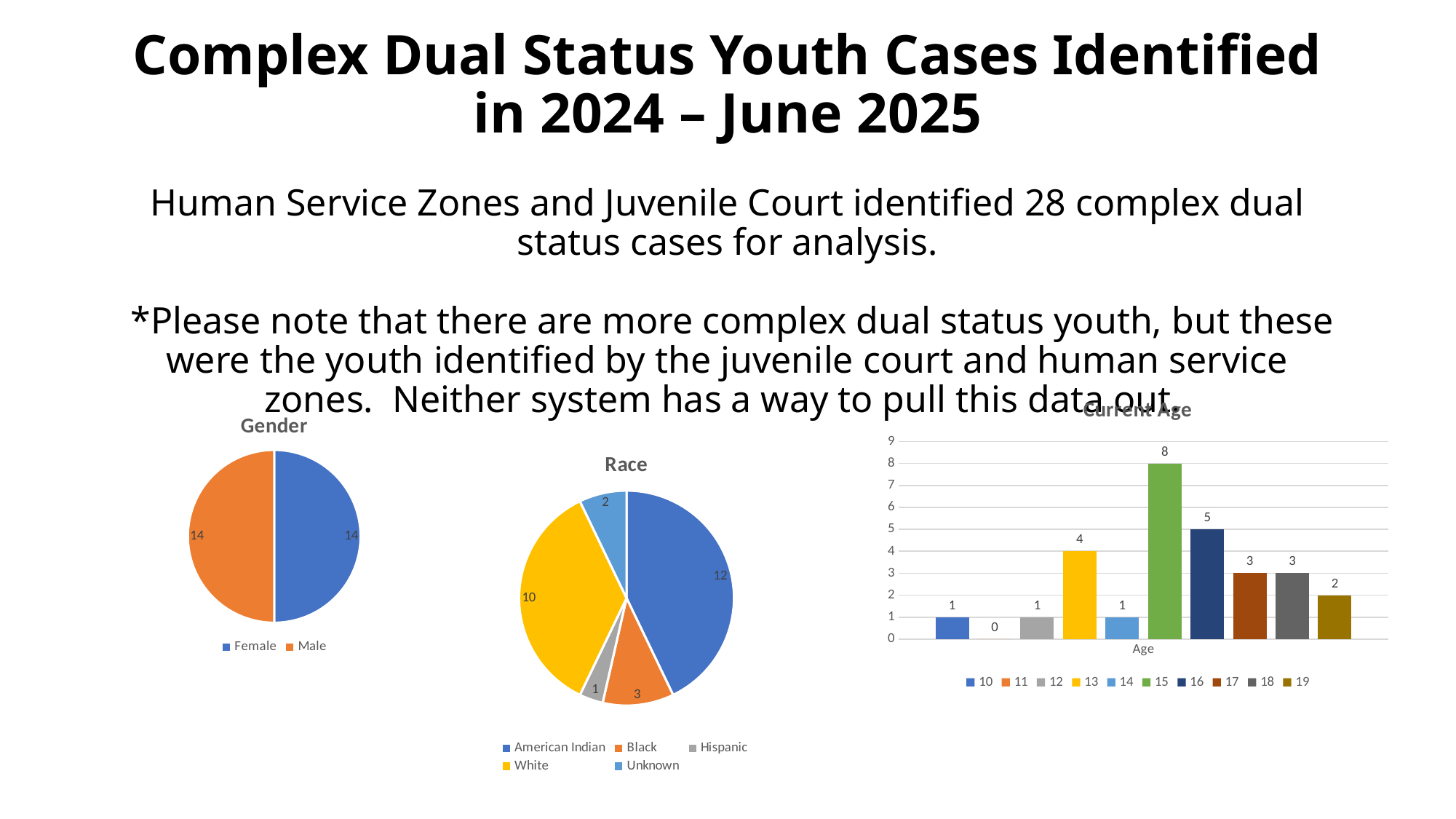
In the Race pie chart, which category has the largest value? American Indian In the Gender pie chart, what is the value for Female? 14 How many categories does the Race pie chart legend list? 5 In the Current Age chart, which age has the highest value? 15 In the Race pie chart, what is the value for White? 10 In the Current Age chart, which is larger, the value for age 13 or the value for age 19? age 13 In the Race pie chart, which category has the smallest value? Hispanic What kind of chart is the Gender chart? pie chart In the Current Age chart, which age has the lowest value? 11 In the Current Age chart, what is the value for age 16? 5 In the Race pie chart, what is the difference between American Indian and Black? 9 What kind of chart is the Current Age chart? bar chart